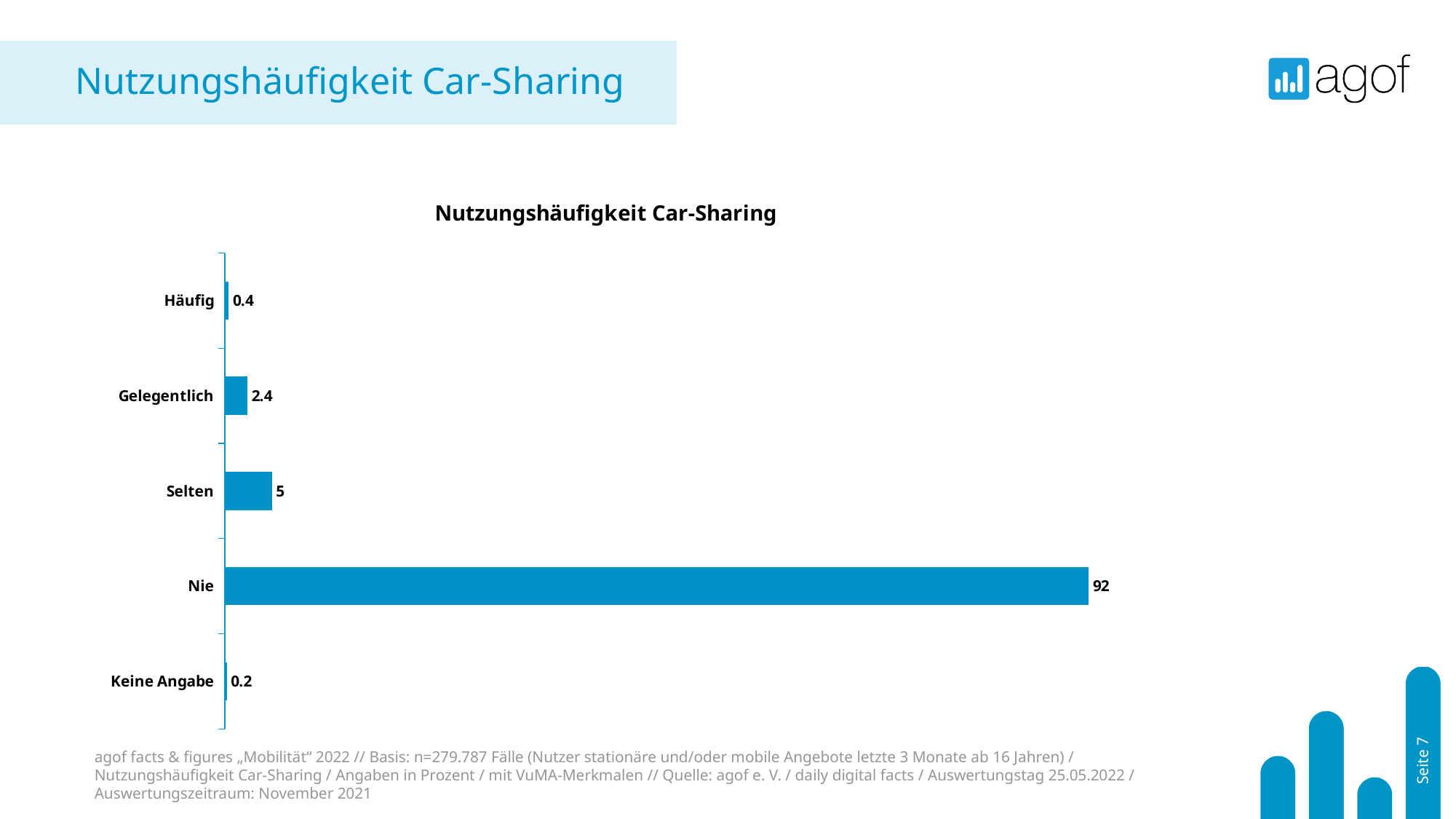
What is the title of the chart? Nutzungshäufigkeit Car-Sharing What is the difference between the values for Selten and Gelegentlich? 2.6 What is the value for Keine Angabe? 0.2 Which is larger, the value for Häufig or the value for Gelegentlich? Gelegentlich Which category has the lowest value? Keine Angabe What is the value for Selten? 5 How many categories are shown in the chart? 5 Which category has the highest value? Nie What is the value for Gelegentlich? 2.4 What is the value for Häufig? 0.4 What is the value for Nie? 92 What kind of chart is shown on the slide? Bar chart